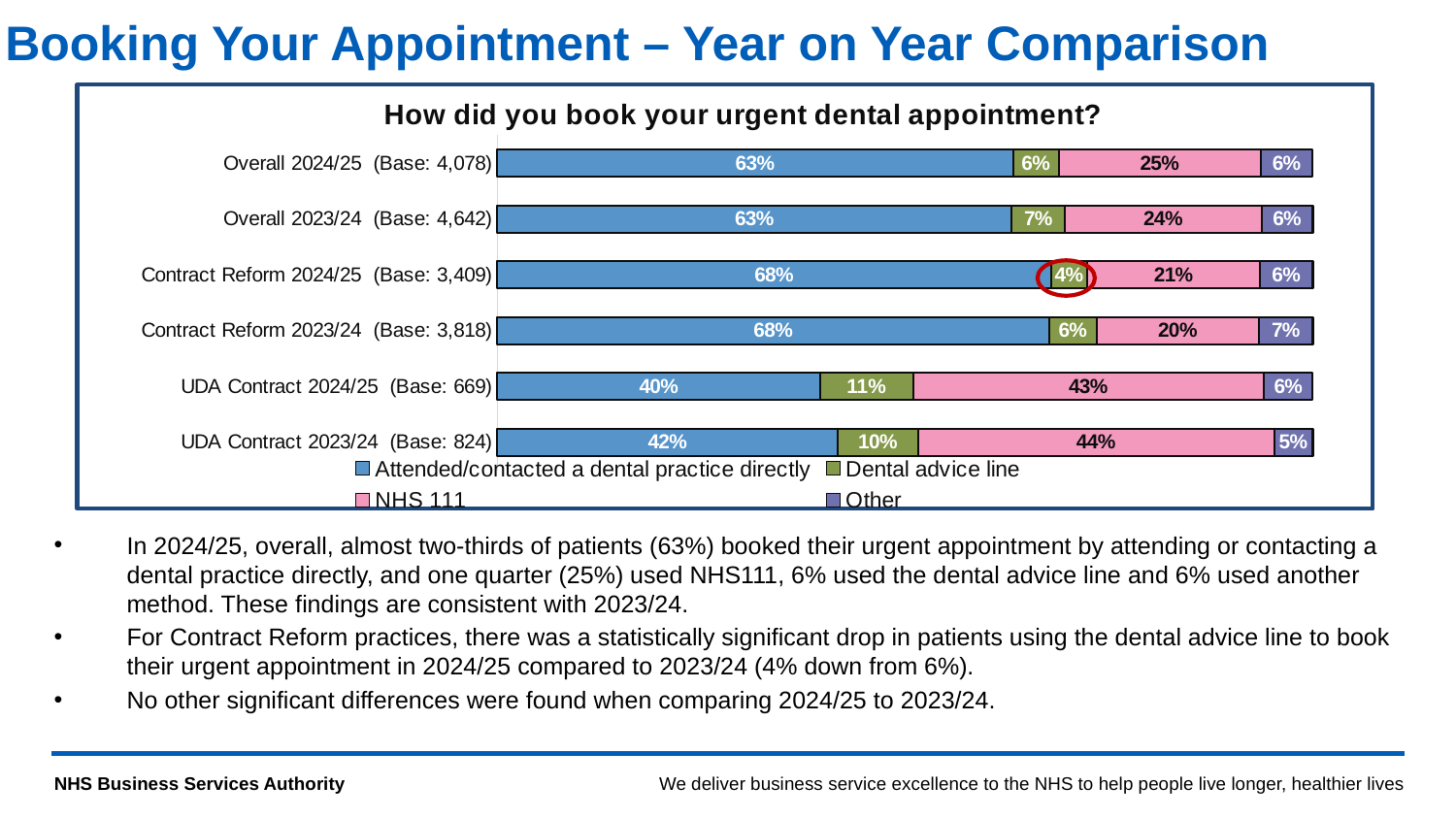
How many categories (bars) are shown in the chart? 6 What percentage of Overall 2024/25 respondents attended/contacted a dental practice directly? 63% What is the difference in the dental advice line percentage between Contract Reform 2023/24 and Contract Reform 2024/25? 2 percentage points How many series does the legend list? 4 Which category has the highest percentage for 'Attended/contacted a dental practice directly'? Contract Reform 2024/25 and Contract Reform 2023/24 (68%) Which is larger: the NHS 111 share for UDA Contract 2024/25 or for Overall 2024/25? UDA Contract 2024/25 What percentage of Contract Reform 2024/25 respondents used the dental advice line? 4% Which category has the lowest percentage for 'Attended/contacted a dental practice directly'? UDA Contract 2024/25 What percentage of UDA Contract 2024/25 respondents used NHS 111? 43% What type of chart is shown on the slide? Stacked bar chart What percentage of UDA Contract 2023/24 respondents used another method (Other)? 5% What is the title of the chart? How did you book your urgent dental appointment?